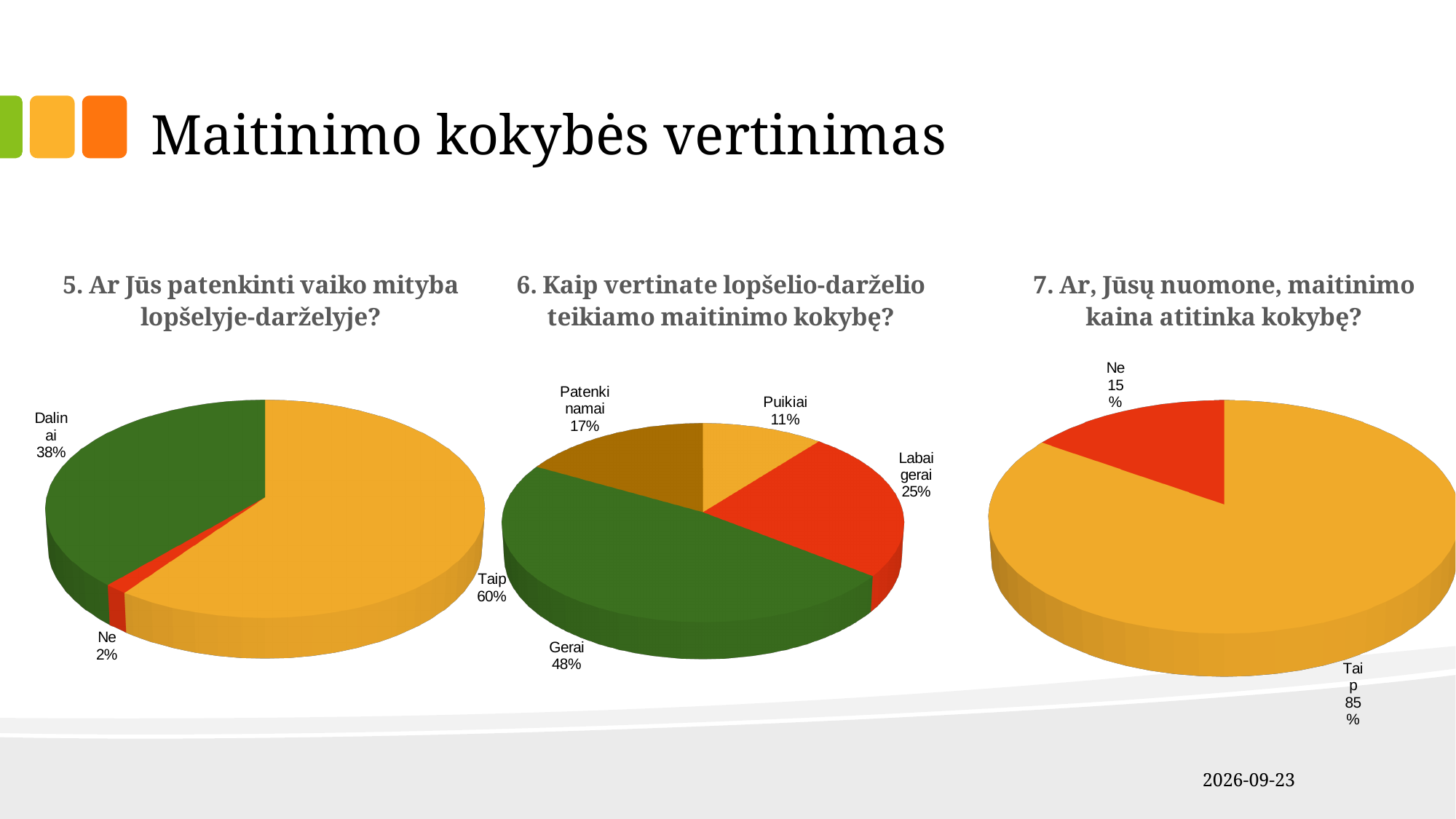
In the left chart (question 5), what share of respondents answered "Dalinai"? 38% In the middle chart (question 6), what share of respondents answered "Puikiai"? 11% In the left chart (question 5), how many slices does the pie have? 3 In the right chart (question 7), what share of respondents answered "Ne"? 15% In the middle chart (question 6), how many slices does the pie have? 4 In the left chart (question 5), which answer has the smallest slice? Ne What kind of chart is used for question 7 on the right? Pie chart In the right chart (question 7), which is larger, "Taip" or "Ne"? Taip In the middle chart (question 6), which answer has the largest slice? Gerai In the middle chart (question 6), what is the difference between the "Labai gerai" and "Patenkinamai" shares? 8%